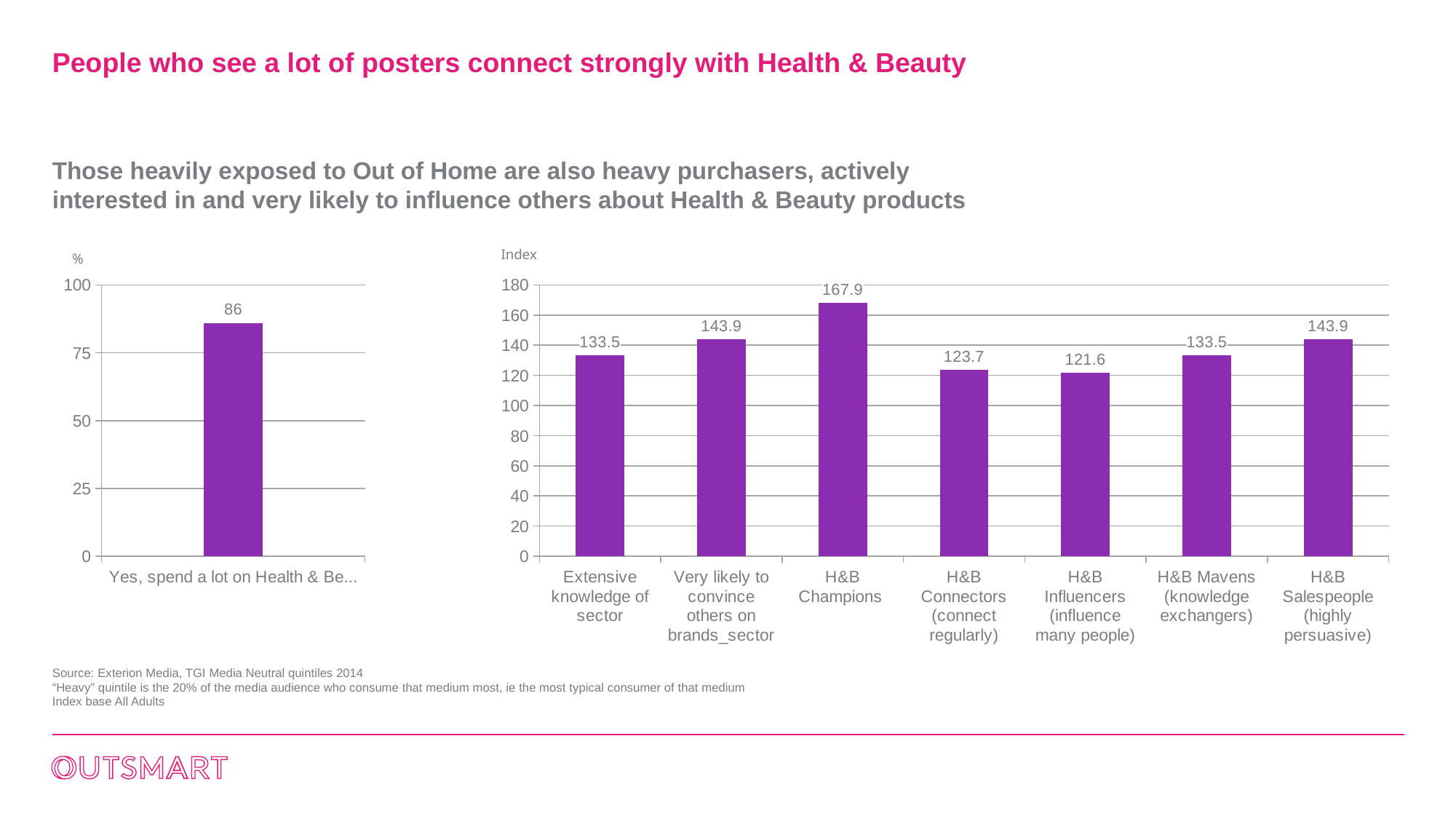
On the right chart, which category has the lowest index value? H&B Influencers (influence many people) On the right chart, what is the index value for H&B Influencers (influence many people)? 121.6 On the left chart, what is the value for 'Yes, spend a lot on Health & Be...'? 86 On the right chart, what is the index value for H&B Connectors (connect regularly)? 123.7 On the right chart, which is larger: the index for Very likely to convince others on brands_sector or the index for Extensive knowledge of sector? Very likely to convince others on brands_sector On the right chart, which category has the highest index value? H&B Champions On the right chart, what is the difference between the index values for H&B Champions and H&B Influencers? 46.3 On the right chart, is the index value for H&B Mavens (knowledge exchangers) greater or less than 120? greater What kind of chart is the right chart? Bar chart On the right chart, what is the index value for H&B Champions? 167.9 What is the axis label shown above the right chart's vertical axis? Index On the right chart, how many categories are plotted? 7